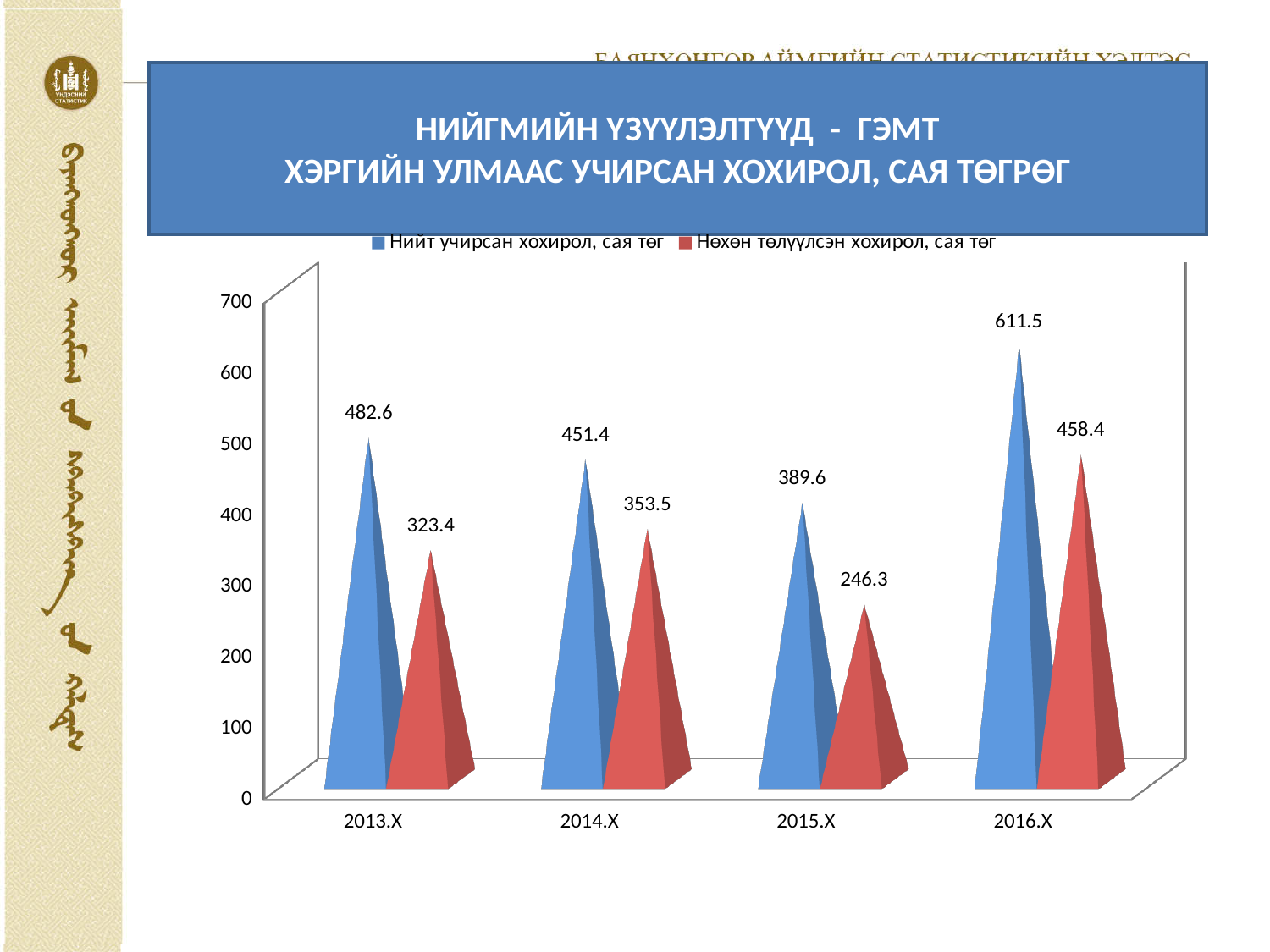
Which is larger in 2014.X: Нийт учирсан хохирол or Нөхөн төлүүлсэн хохирол? Нийт учирсан хохирол What is the difference between Нийт учирсан хохирол and Нөхөн төлүүлсэн хохирол in 2016.X? 153.1 What kind of chart is shown on the slide? bar chart Which year has the lowest value for Нөхөн төлүүлсэн хохирол, сая төг? 2015.X Which year has the highest value for Нийт учирсан хохирол, сая төг? 2016.X What is the value of Нөхөн төлүүлсэн хохирол, сая төг for 2015.X? 246.3 Which colour represents Нөхөн төлүүлсэн хохирол, сая төг in the legend? red What is the value of Нийт учирсан хохирол, сая төг for 2013.X? 482.6 How many years are shown on the x axis? 4 What is the value of Нийт учирсан хохирол, сая төг for 2016.X? 611.5 How many series does the legend list? 2 Is the value of Нөхөн төлүүлсэн хохирол for 2014.X greater or less than 300? greater